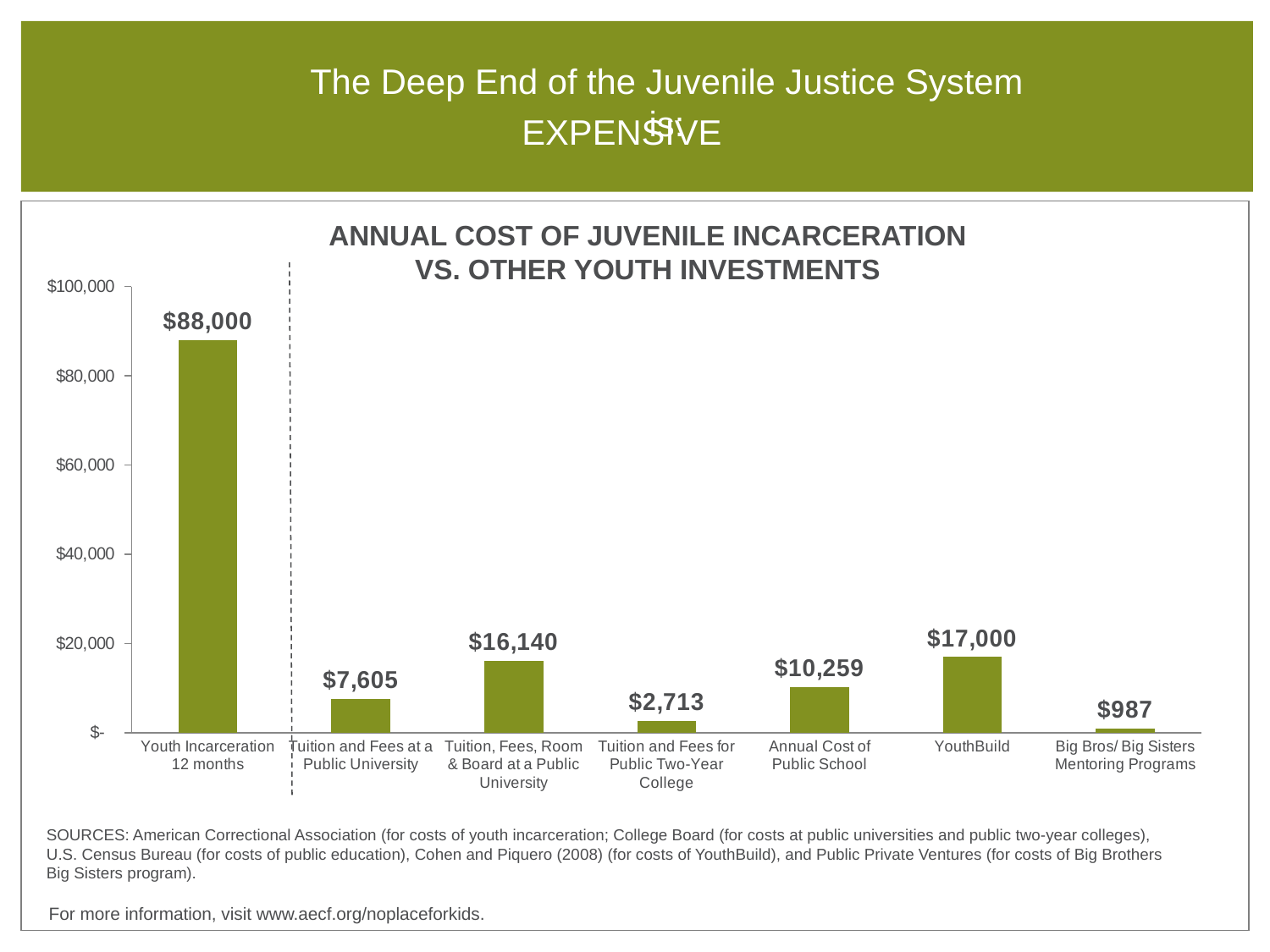
What is the value for YouthBuild? $17,000 What is the annual cost of Youth Incarceration 12 months? $88,000 How many categories are shown in the chart? 7 Which category has the lowest value? Big Bros/ Big Sisters Mentoring Programs Which is larger: YouthBuild or Tuition, Fees, Room & Board at a Public University? YouthBuild What is the value for Tuition and Fees for Public Two-Year College? $2,713 What is the value for Annual Cost of Public School? $10,259 What is the difference between Youth Incarceration 12 months and YouthBuild? $71,000 What kind of chart is shown on the slide? Bar chart Which category has the highest value? Youth Incarceration 12 months What is the difference between Tuition, Fees, Room & Board at a Public University and Tuition and Fees at a Public University? $8,535 What is the title of the chart? ANNUAL COST OF JUVENILE INCARCERATION VS. OTHER YOUTH INVESTMENTS